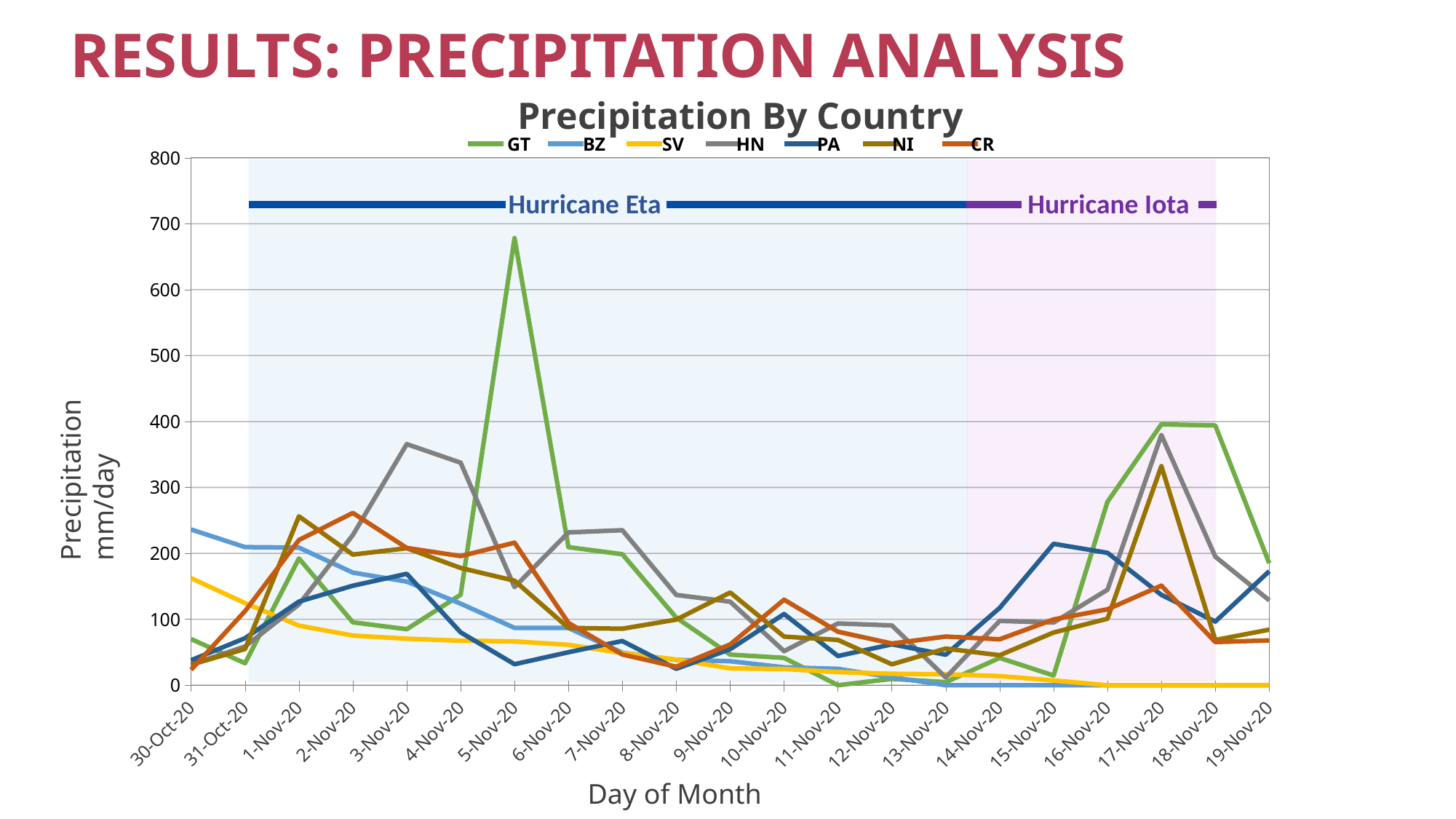
Is the value for GT on 5-Nov-20 greater or less than 600? greater Is the value for GT on 17-Nov-20 greater or less than 300? greater Is the value for SV on 19-Nov-20 greater or less than 100? less What is the title of the chart? Precipitation By Country How many dates are shown along the x axis of the chart? 21 What kind of chart is shown on the slide? line chart How many series does the legend of the Precipitation By Country chart list? 7 Which series reaches the highest value anywhere on the chart? GT On 5-Nov-20, which series has the larger value, GT or HN? GT What is the label of the x axis of the chart? Day of Month